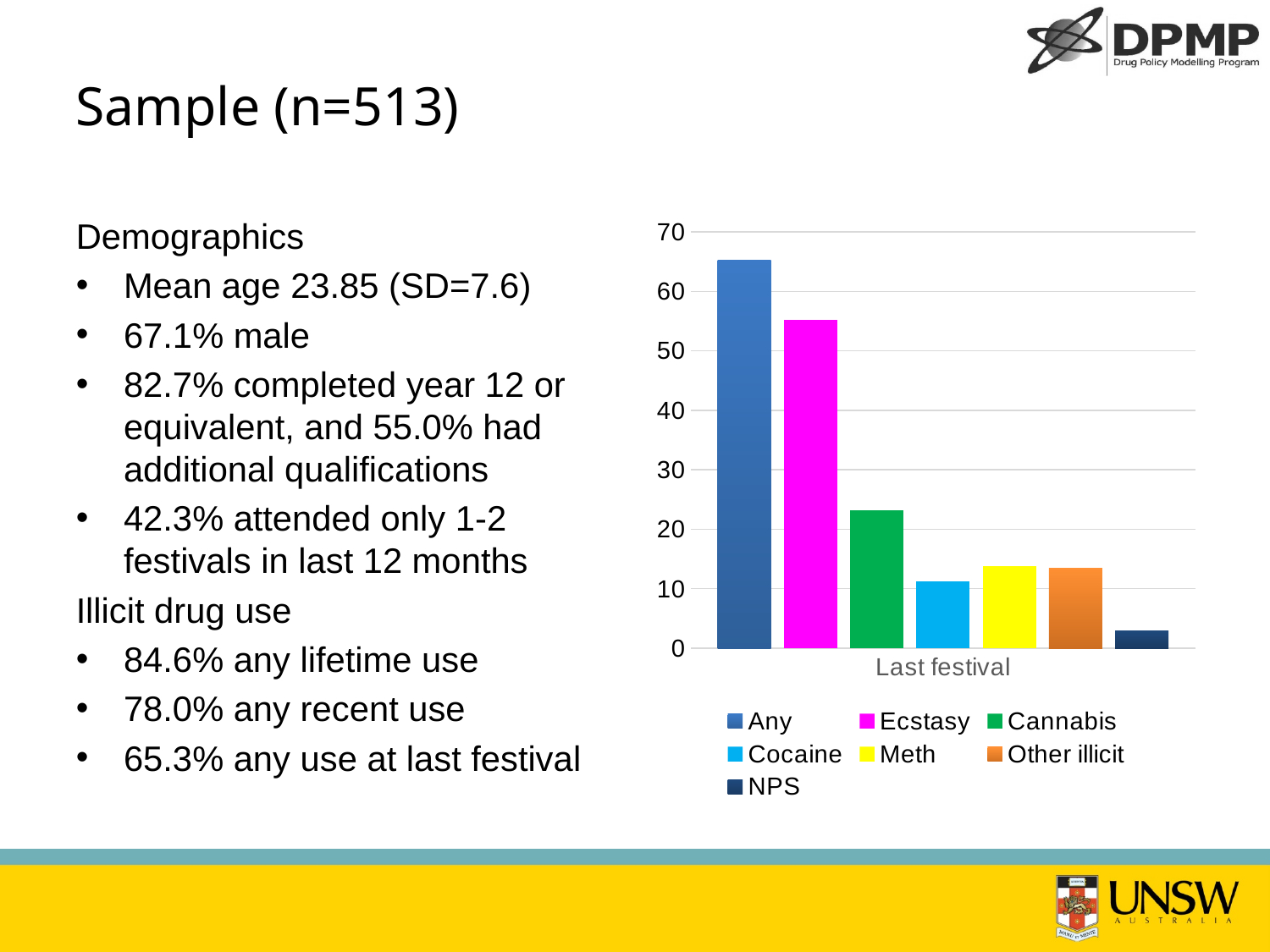
Which series has the lowest bar in the chart? NPS Is the value for Ecstasy greater or less than 50? greater What is the category label shown on the x axis of the chart? Last festival Which is larger, the value for Cannabis or the value for Cocaine? Cannabis How many series does the chart's legend list? 7 Is the value for NPS greater or less than 10? less How many categories are shown on the x axis of the chart? 1 What kind of chart is shown on the slide? bar chart Is the value for Cannabis greater or less than 30? less Which is larger, the value for Ecstasy or the value for Cannabis? Ecstasy Which series has the highest bar in the chart? Any